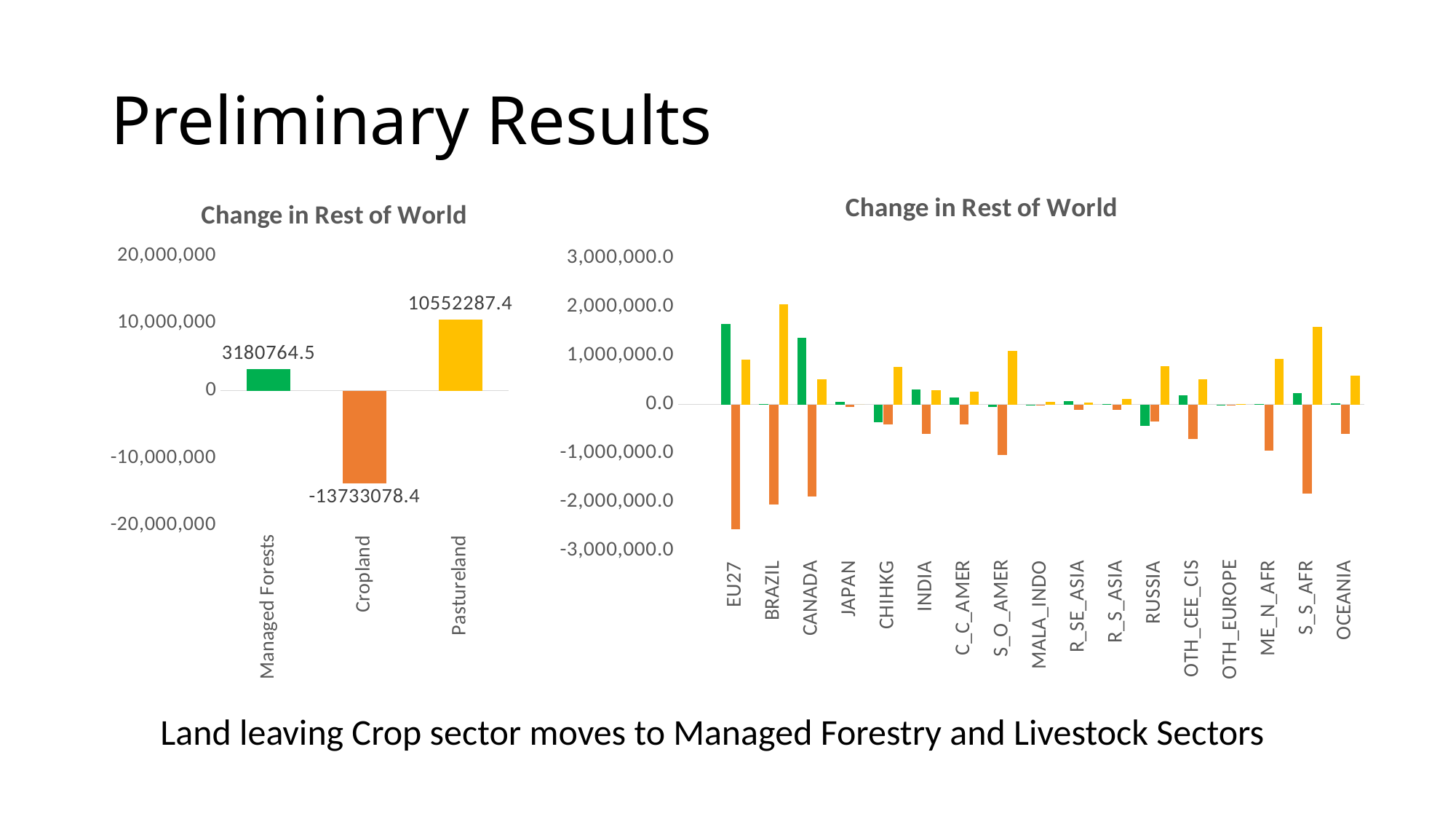
On the left chart, what is the value for Cropland? -13733078.4 On the left chart, which category has the lowest value? Cropland On the left chart, what is the value for Managed Forests? 3180764.5 On the right chart, which region has the tallest green bar? EU27 On the left chart, what is the value for Pastureland? 10552287.4 On the left chart, how many categories are shown? 3 On the left chart, what is the difference between the Pastureland value and the Managed Forests value? 7371522.9 On the left chart, which category has the highest value? Pastureland On the right chart, is the yellow bar for S_S_AFR greater or less than 1,000,000.0? greater On the right chart, is the orange bar for EU27 greater or less than -2,000,000.0? less What kind of chart is the left chart? Bar chart On the right chart, how many regions are shown on the x axis? 17